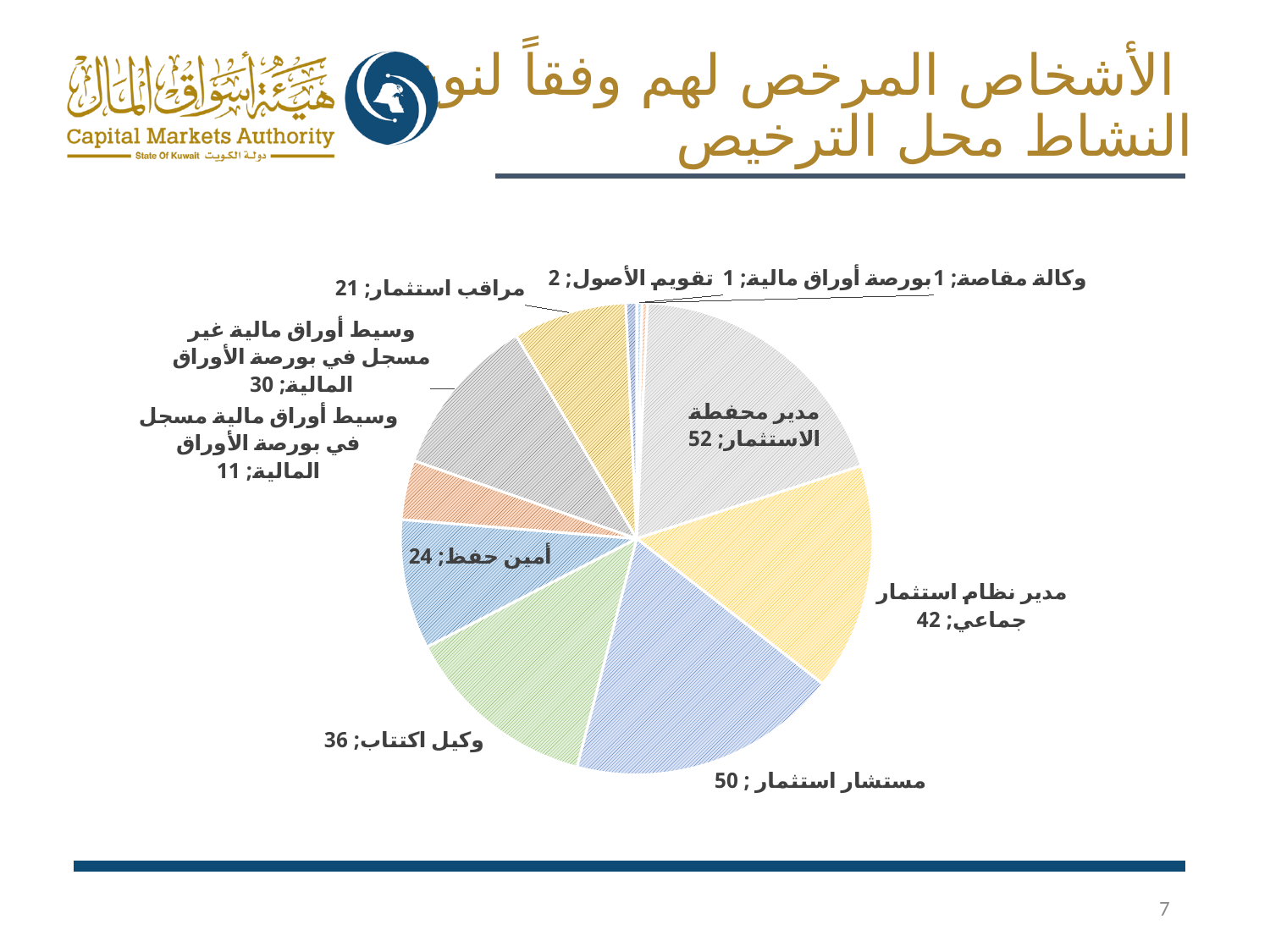
What is the value for وكيل اكتتاب? 36 What is the value for تقويم الأصول? 2 What is the difference between the values for مدير محفظة الاستثمار and مستشار استثمار? 2 What is the value for مستشار استثمار? 50 What type of chart is shown on the slide? pie chart What is the value for مدير محفظة الاستثمار? 52 What is the difference between the values for وسيط أوراق مالية غير مسجل في بورصة الأوراق المالية and وسيط أوراق مالية مسجل في بورصة الأوراق المالية? 19 Which is larger, مدير نظام استثمار جماعي or أمين حفظ? مدير نظام استثمار جماعي What is the total of all the values shown in the pie chart? 270 Which category has the largest value in the pie chart? مدير محفظة الاستثمار How many categories (slices) does the pie chart show? 11 What is the value for وسيط أوراق مالية غير مسجل في بورصة الأوراق المالية? 30